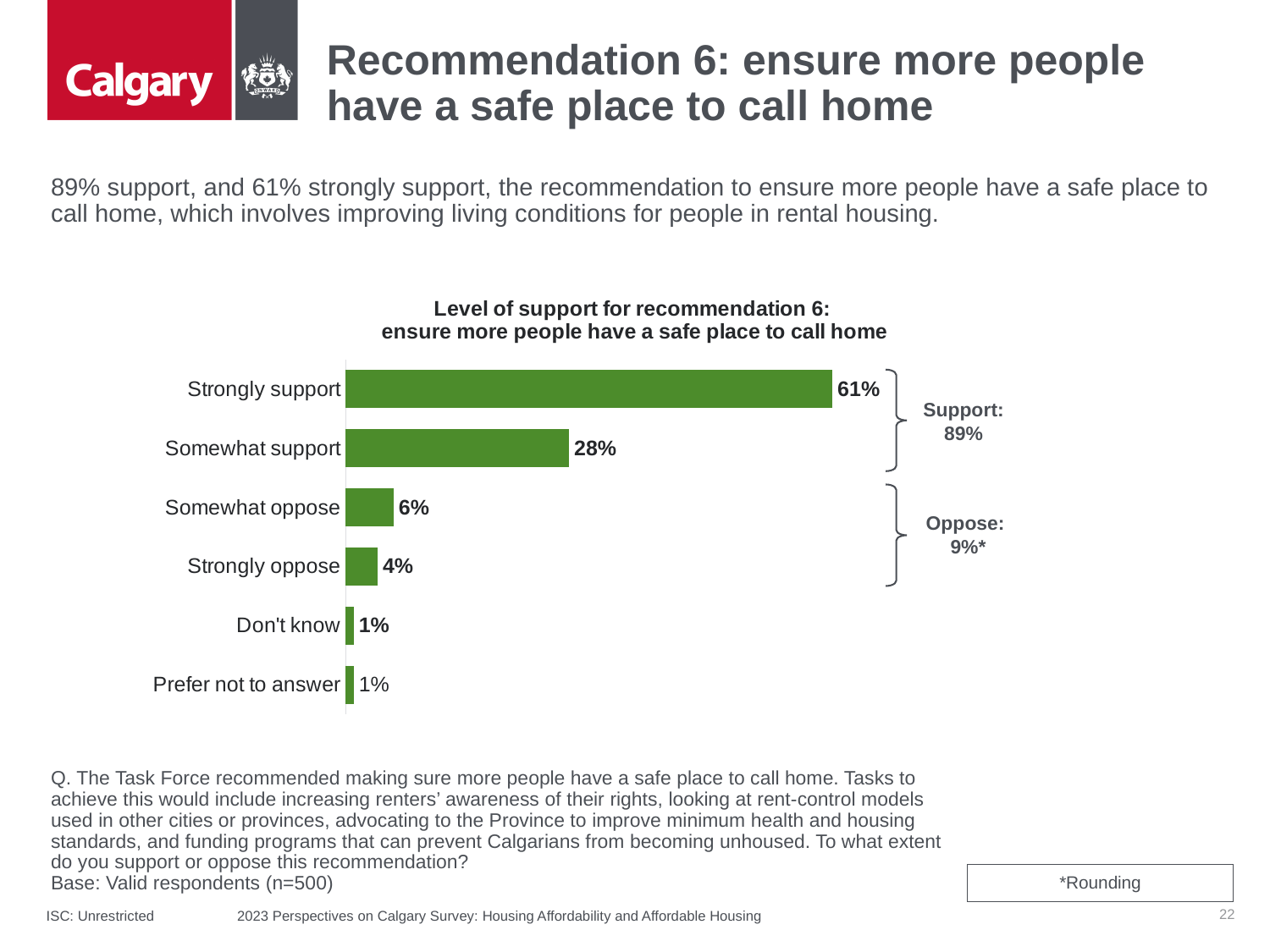
What is the combined Support percentage shown beside the bracket? 89% What kind of chart is shown? Bar chart What is the value for Somewhat support? 28% What is the value for Don't know? 1% What is the value for Somewhat oppose? 6% What is the value for Strongly oppose? 4% What percentage of respondents strongly support recommendation 6? 61% What is the combined Oppose percentage shown beside the bracket? 9%* Which category has the highest value? Strongly support How many categories are shown in the chart? 6 What is the difference between Strongly support and Somewhat support? 33 percentage points Which is larger, Somewhat oppose or Strongly oppose? Somewhat oppose